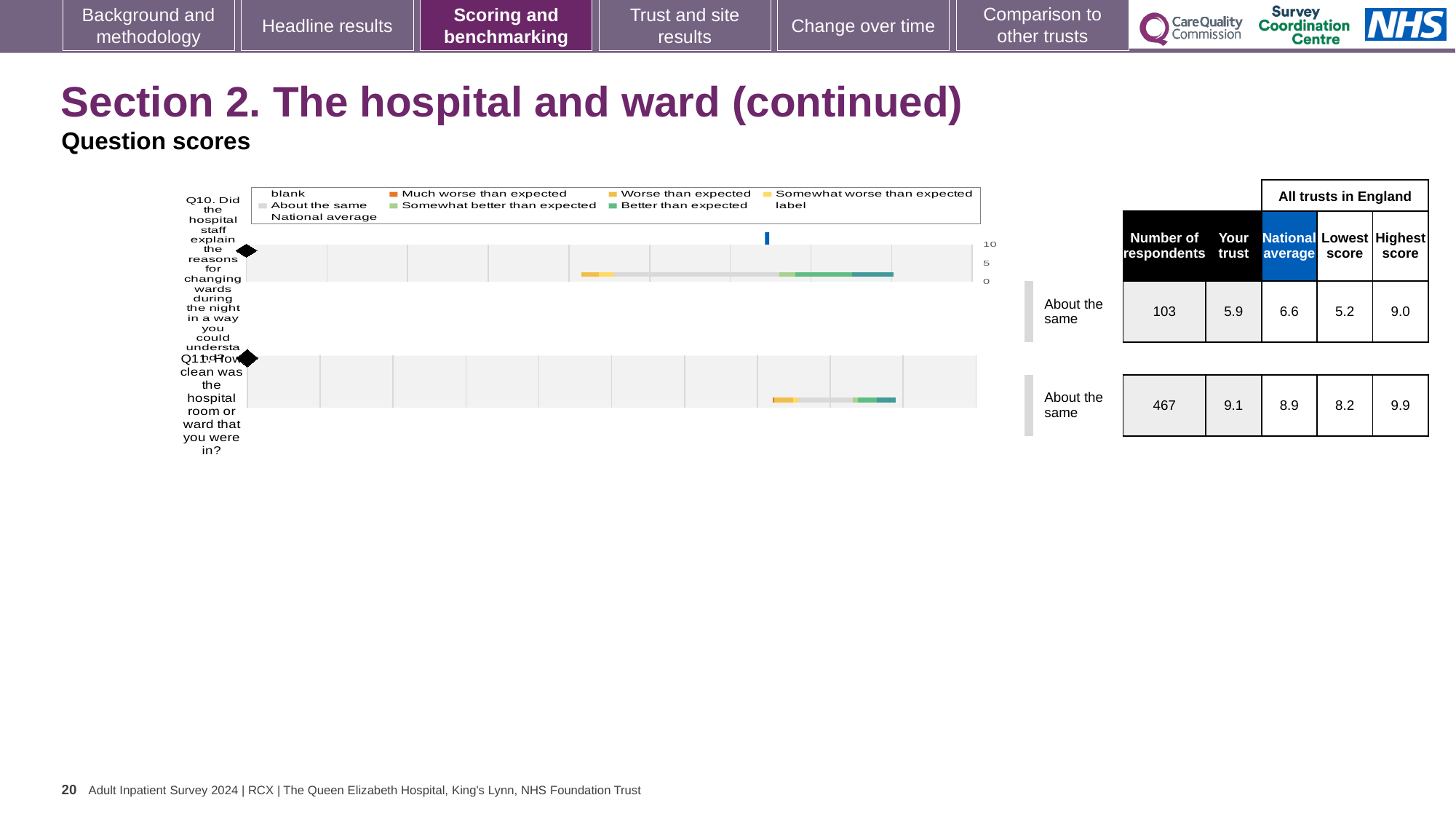
How many respondents answered Q11? 467 How many questions are plotted on this slide? 2 What is the lowest score among all trusts in England for Q11? 8.2 For Q10, which is larger: the 'Your trust' score or the national average? National average Which question has the higher 'Your trust' score, Q10 or Q11? Q11 For Q10, what is the difference between the highest and lowest scores among all trusts in England? 3.8 What is the highest score among all trusts in England for Q10? 9.0 What is the 'Your trust' score for Q11 (How clean was the hospital room or ward that you were in?)? 9.1 What kind of chart is used to show the question scores for Q10 and Q11? bar chart For Q11, what is the difference between the 'Your trust' score and the national average? 0.2 What is the national average score for Q10 (Did the hospital staff explain the reasons for changing wards during the night)? 6.6 What benchmark category is shown for Q10? About the same